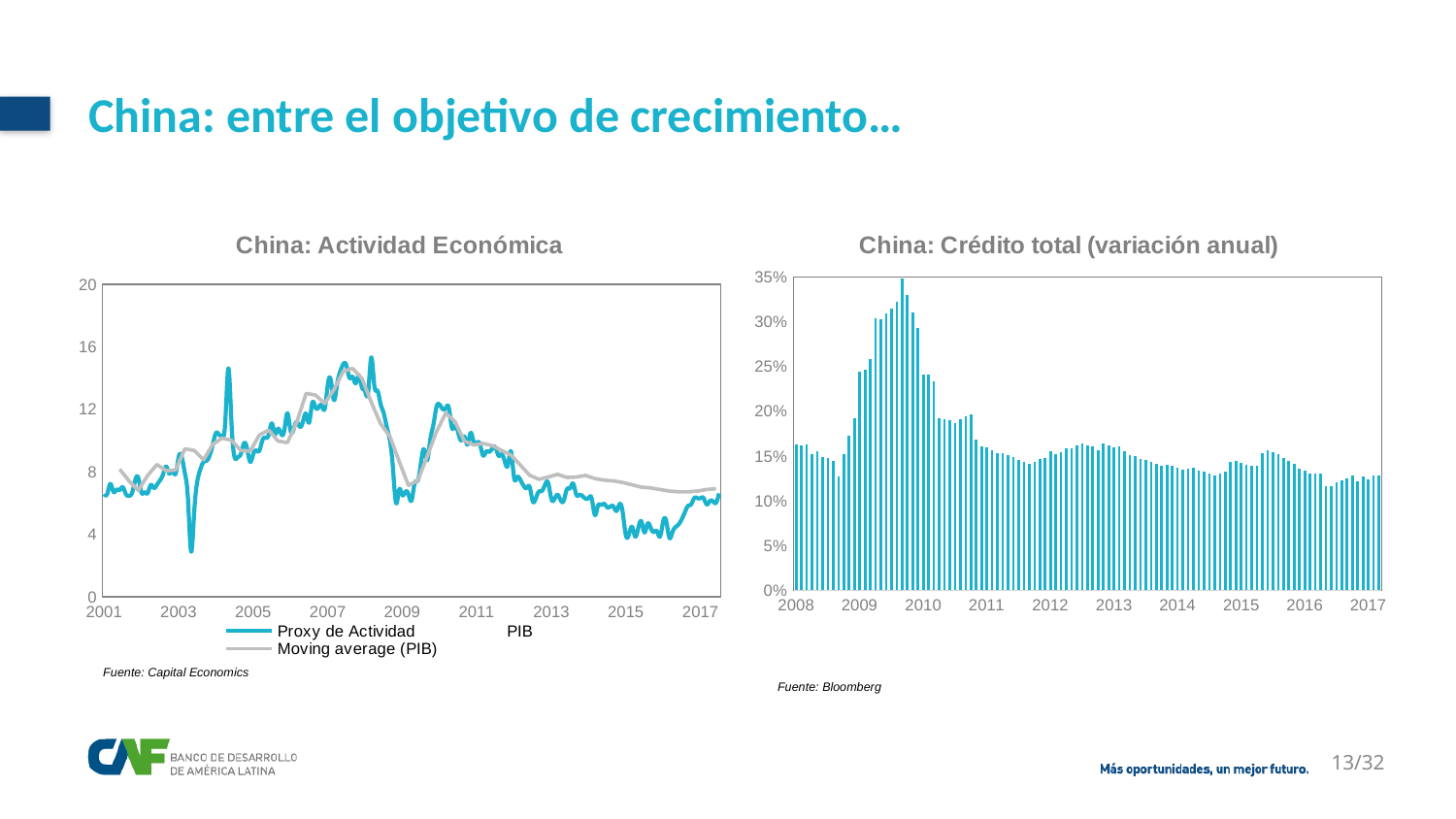
In 'China: Crédito total (variación anual)', is the highest bar in 2009 greater or less than 30%? greater What kind of chart is 'China: Actividad Económica'? line chart In 'China: Actividad Económica', is the peak value of Proxy de Actividad around 2008 greater or less than 12? greater In 'China: Crédito total (variación anual)', in which year does the tallest bar occur? 2010 In 'China: Actividad Económica', is the lowest dip of Proxy de Actividad around 2003 greater or less than 4? less What kind of chart is 'China: Crédito total (variación anual)'? bar chart What source is cited for the 'China: Crédito total (variación anual)' chart? Bloomberg How many series does the legend of 'China: Actividad Económica' list? 3 In 'China: Actividad Económica', what are the three series named in the legend? Proxy de Actividad, PIB, Moving average (PIB) In 'China: Crédito total (variación anual)', do the values generally rise or fall from 2010 to 2017? fall